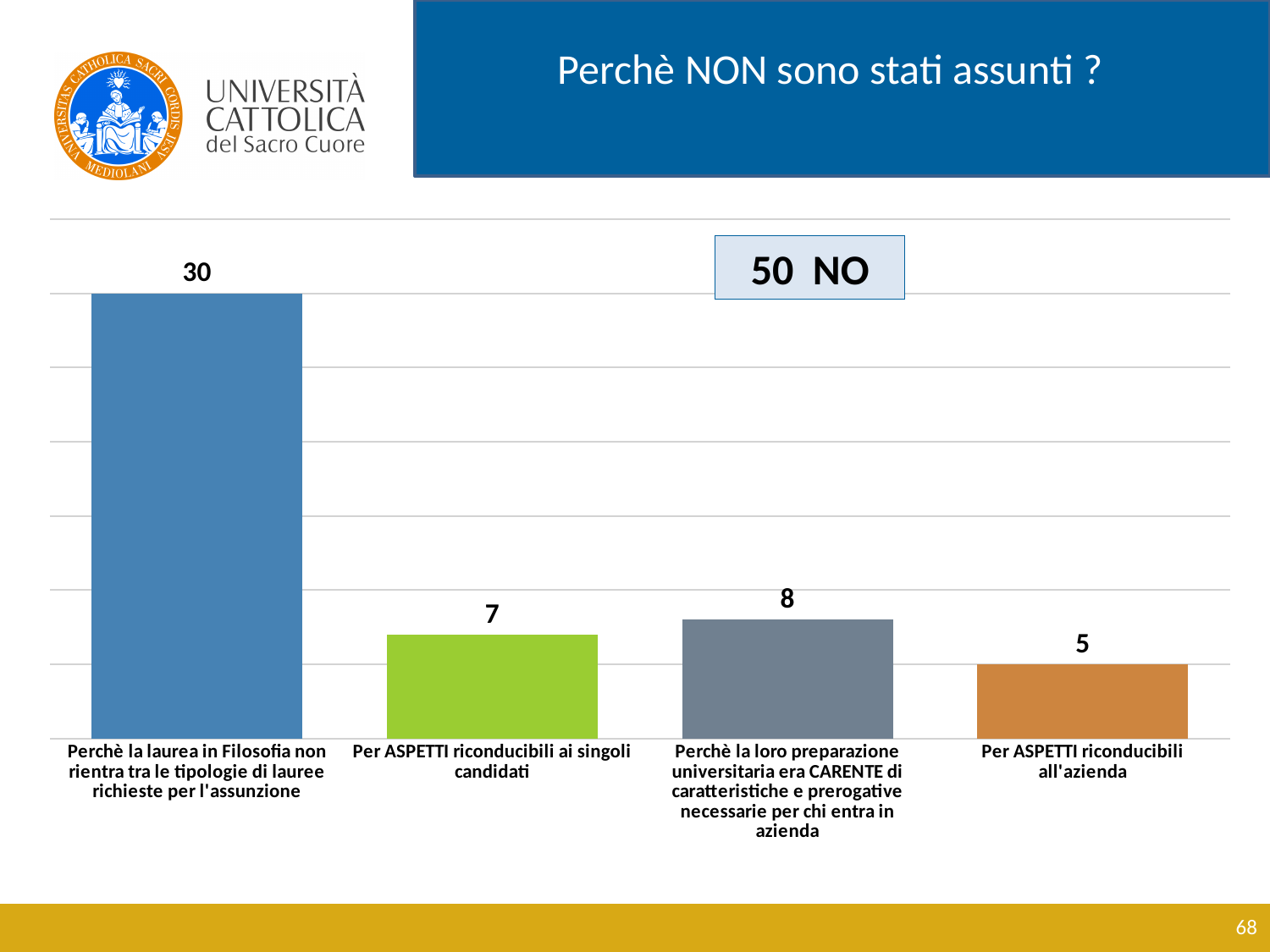
What is the difference between the value for "Perchè la loro preparazione universitaria era CARENTE..." and the value for "Per ASPETTI riconducibili ai singoli candidati"? 1 What is the value for "Per ASPETTI riconducibili all'azienda"? 5 Which is larger: the value for "Per ASPETTI riconducibili ai singoli candidati" or the value for "Per ASPETTI riconducibili all'azienda"? Per ASPETTI riconducibili ai singoli candidati How many categories are shown in the chart? 4 What is the difference between the value for "Perchè la laurea in Filosofia non rientra tra le tipologie di lauree richieste per l'assunzione" and the value for "Per ASPETTI riconducibili all'azienda"? 25 Which category has the highest value? Perchè la laurea in Filosofia non rientra tra le tipologie di lauree richieste per l'assunzione Which category has the lowest value? Per ASPETTI riconducibili all'azienda What is the value for "Perchè la loro preparazione universitaria era CARENTE di caratteristiche e prerogative necessarie per chi entra in azienda"? 8 What is the value for "Per ASPETTI riconducibili ai singoli candidati"? 7 What is the title of the slide containing the chart? Perchè NON sono stati assunti ? What is the value for "Perchè la laurea in Filosofia non rientra tra le tipologie di lauree richieste per l'assunzione"? 30 What kind of chart is shown on the slide? Bar chart